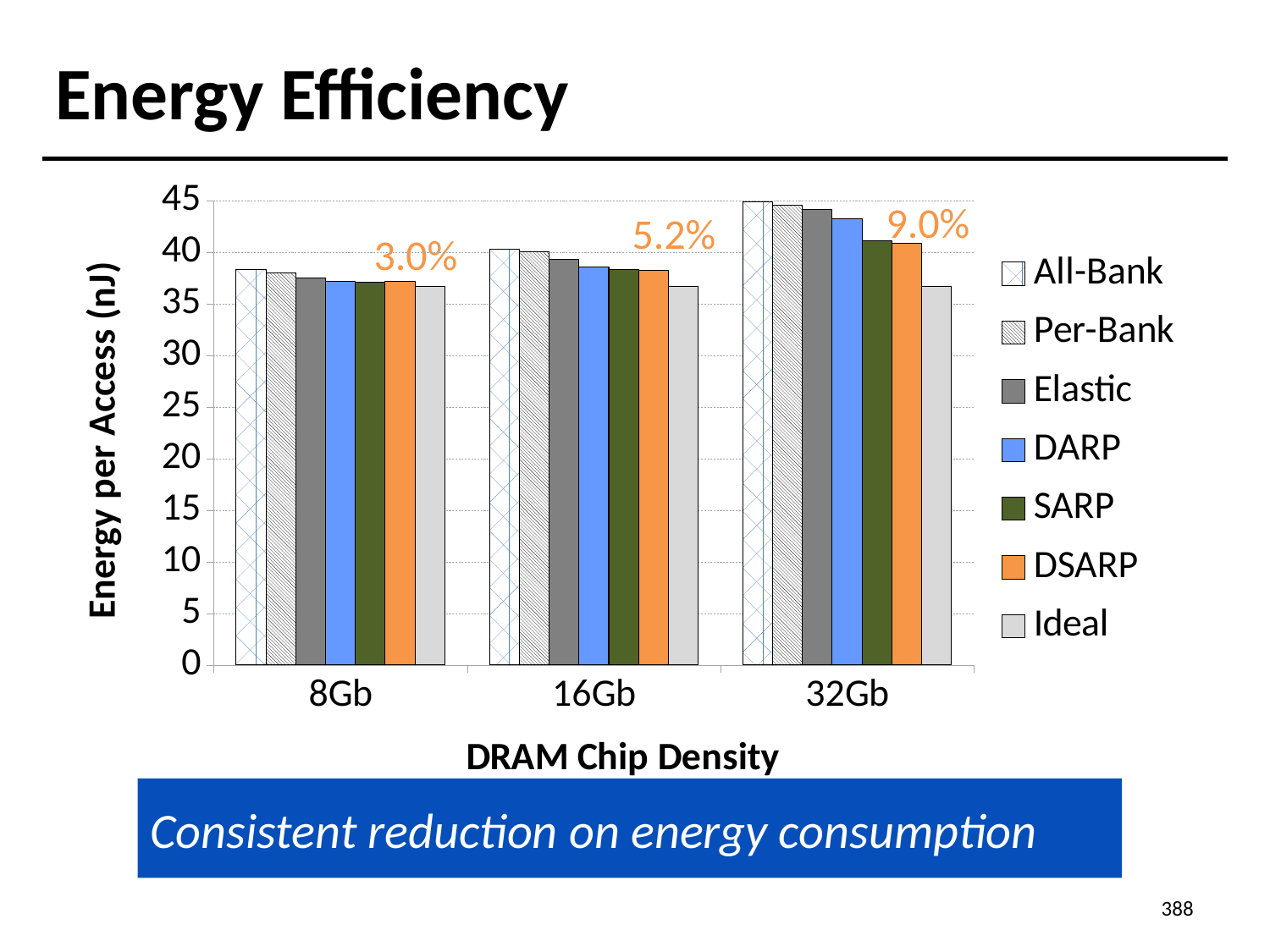
Which series has the lowest energy per access at 32Gb? Ideal What kind of chart is shown on the slide? bar chart Is the DARP value at 32Gb greater or less than 40? greater What percentage is printed above the 32Gb group of bars? 9.0% Which series has the highest energy per access at 32Gb? All-Bank Is the SARP value at 16Gb greater or less than 40? less Is the All-Bank value at 8Gb greater or less than 35? greater Does the All-Bank energy per access rise or fall as DRAM chip density increases from 8Gb to 32Gb? rise How many series does the legend list? 7 How many DRAM chip density categories are shown on the x axis? 3 What percentage is printed above the 16Gb group of bars? 5.2% What percentage is printed above the 8Gb group of bars? 3.0%